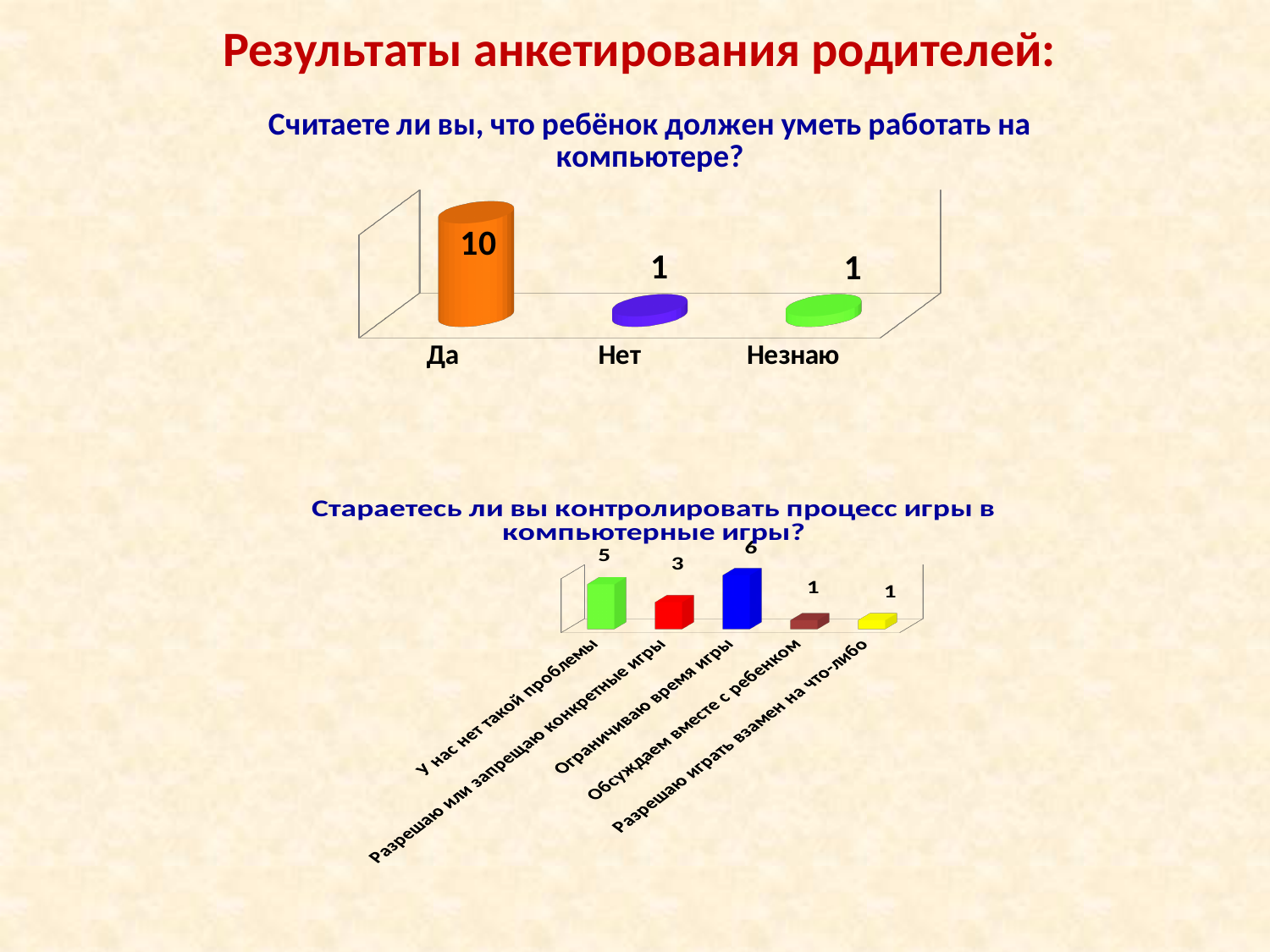
In the top chart ("Считаете ли вы, что ребёнок должен уметь работать на компьютере?"), what is the difference between the values for "Да" and "Незнаю"? 9 In the top chart ("Считаете ли вы, что ребёнок должен уметь работать на компьютере?"), how many categories are shown? 3 What type of chart is the bottom chart ("Стараетесь ли вы контролировать процесс игры в компьютерные игры?")? Bar chart In the bottom chart ("Стараетесь ли вы контролировать процесс игры в компьютерные игры?"), which is larger: "У нас нет такой проблемы" or "Разрешаю или запрещаю конкретные игры"? У нас нет такой проблемы In the bottom chart ("Стараетесь ли вы контролировать процесс игры в компьютерные игры?"), what is the value for "У нас нет такой проблемы"? 5 In the top chart ("Считаете ли вы, что ребёнок должен уметь работать на компьютере?"), what is the value for "Нет"? 1 In the bottom chart ("Стараетесь ли вы контролировать процесс игры в компьютерные игры?"), how many categories are shown? 5 In the top chart ("Считаете ли вы, что ребёнок должен уметь работать на компьютере?"), which category has the highest value? Да In the bottom chart ("Стараетесь ли вы контролировать процесс игры в компьютерные игры?"), what is the value for "Ограничиваю время игры"? 6 In the top chart ("Считаете ли вы, что ребёнок должен уметь работать на компьютере?"), what is the total of all the values shown? 12 In the bottom chart ("Стараетесь ли вы контролировать процесс игры в компьютерные игры?"), which category has the highest value? Ограничиваю время игры In the top chart ("Считаете ли вы, что ребёнок должен уметь работать на компьютере?"), what is the value for "Да"? 10